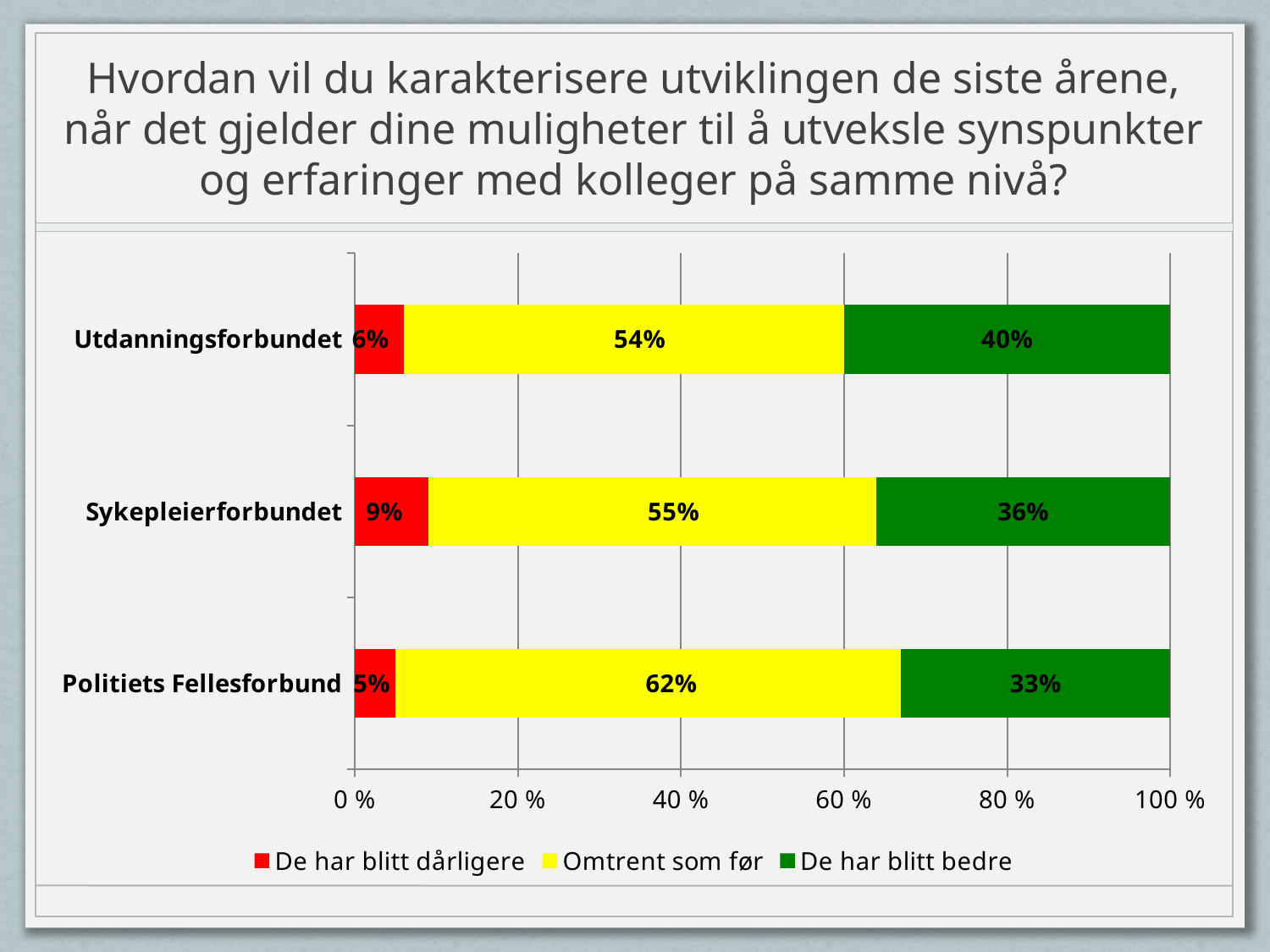
What is the value for "Omtrent som før" for Politiets Fellesforbund? 62% What is the difference between the "De har blitt bedre" values for Utdanningsforbundet and Sykepleierforbundet? 4% What percentage of Utdanningsforbundet respondents answered "De har blitt bedre"? 40% Which category has the highest value for "Omtrent som før"? Politiets Fellesforbund What kind of chart is shown on the slide? Stacked bar chart How many categories are shown on the y axis? 3 Which category has the lowest value for "De har blitt bedre"? Politiets Fellesforbund What is the total of the stacked bar for Sykepleierforbundet? 100% Which is larger: the "De har blitt dårligere" value for Sykepleierforbundet or for Politiets Fellesforbund? Sykepleierforbundet Which colour represents "De har blitt bedre" in the legend? Green What percentage of Sykepleierforbundet respondents answered "De har blitt dårligere"? 9% How many series does the legend list? 3